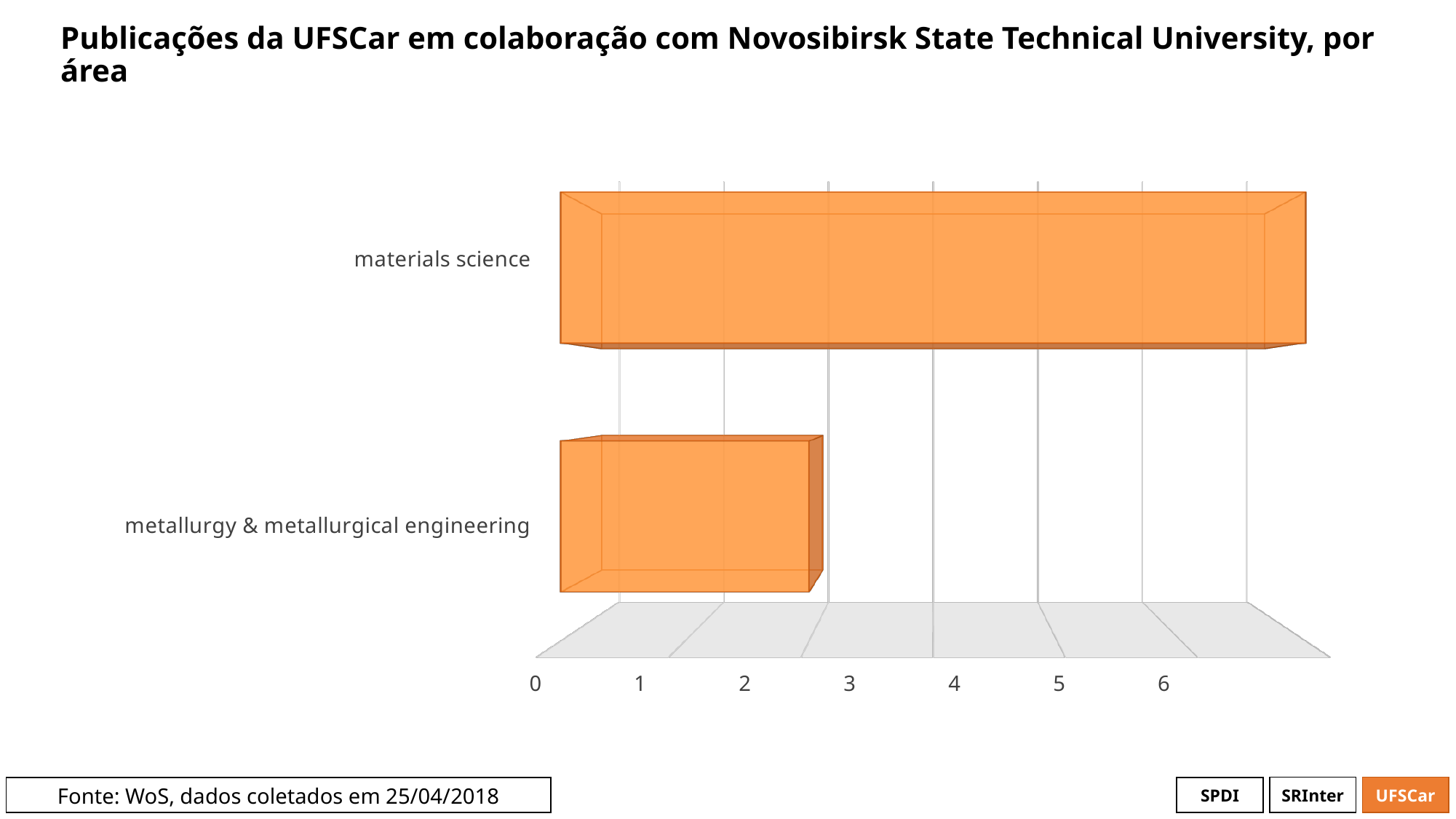
What is the highest tick value shown on the horizontal axis? 6 Which area has the lowest number of publications? metallurgy & metallurgical engineering Is the value for metallurgy & metallurgical engineering greater or less than 4? less Which has more publications: materials science or metallurgy & metallurgical engineering? materials science Is the value for metallurgy & metallurgical engineering greater or less than 1? greater Is the value for materials science greater or less than 5? greater How many categories (areas) are plotted in the chart? 2 Which area has the highest number of publications? materials science What kind of chart is shown on the slide? bar chart What colour are the bars in the chart? orange